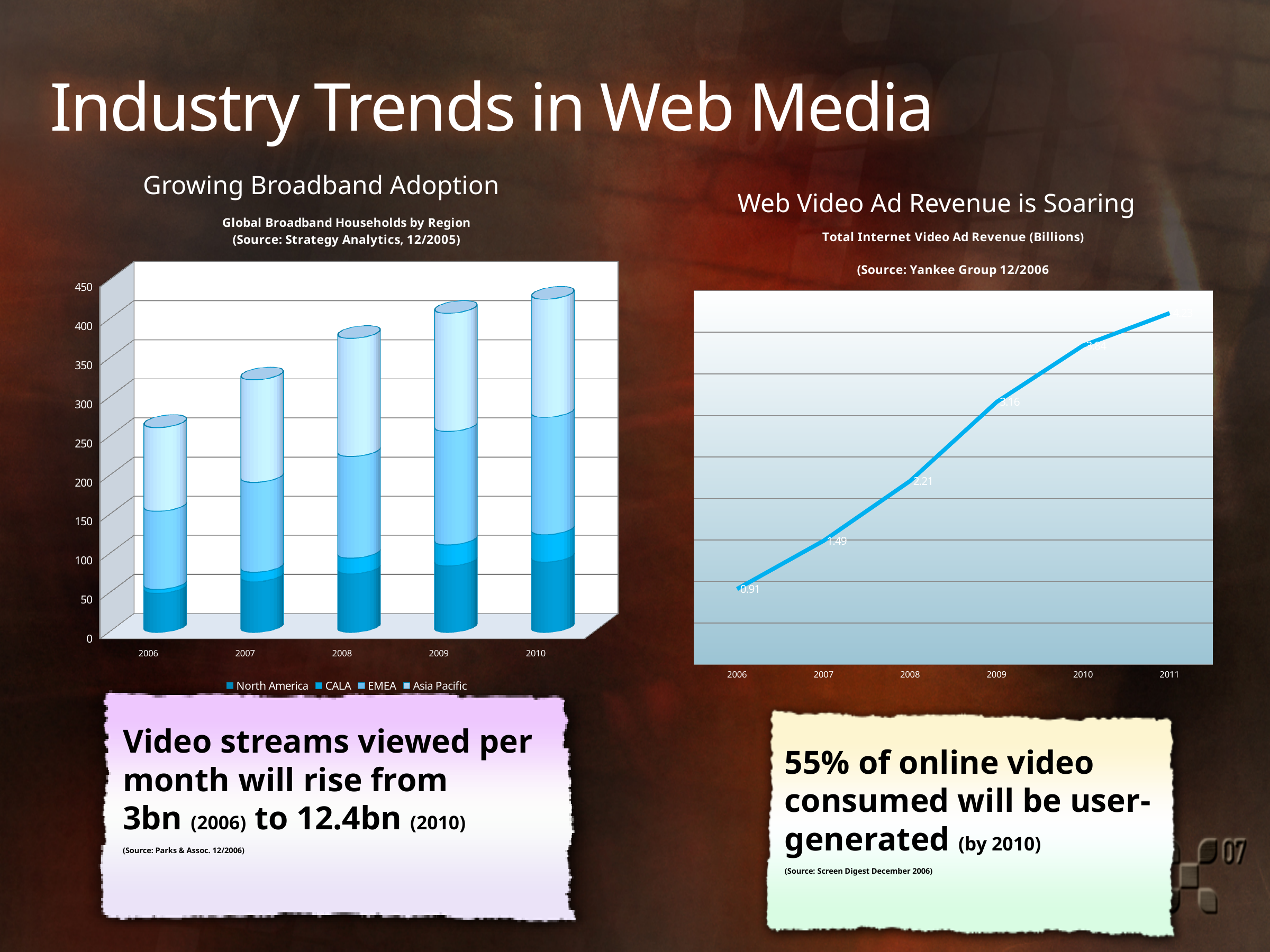
In the Total Internet Video Ad Revenue chart, what is the value for 2006? 0.91 How many years are shown on the x axis of the Global Broadband Households by Region chart? 5 What kind of chart is the Global Broadband Households by Region chart on the left? bar chart In the Total Internet Video Ad Revenue chart, what is the difference between the 2009 and 2007 values? 1.67 Which regions are listed in the legend of the Global Broadband Households by Region chart? North America, CALA, EMEA, Asia Pacific In the Global Broadband Households by Region chart, do the total bar heights rise or fall from 2006 to 2010? rise How many series does the legend of the Global Broadband Households by Region chart list? 4 In the Total Internet Video Ad Revenue chart, what is the value for 2009? 3.16 In the Global Broadband Households by Region chart, is the total for 2006 greater or less than 300? less What kind of chart is the Total Internet Video Ad Revenue chart on the right? line chart In the Global Broadband Households by Region chart, is the total for 2010 greater or less than 400? greater In the Global Broadband Households by Region chart, which year has the tallest stacked bar? 2010